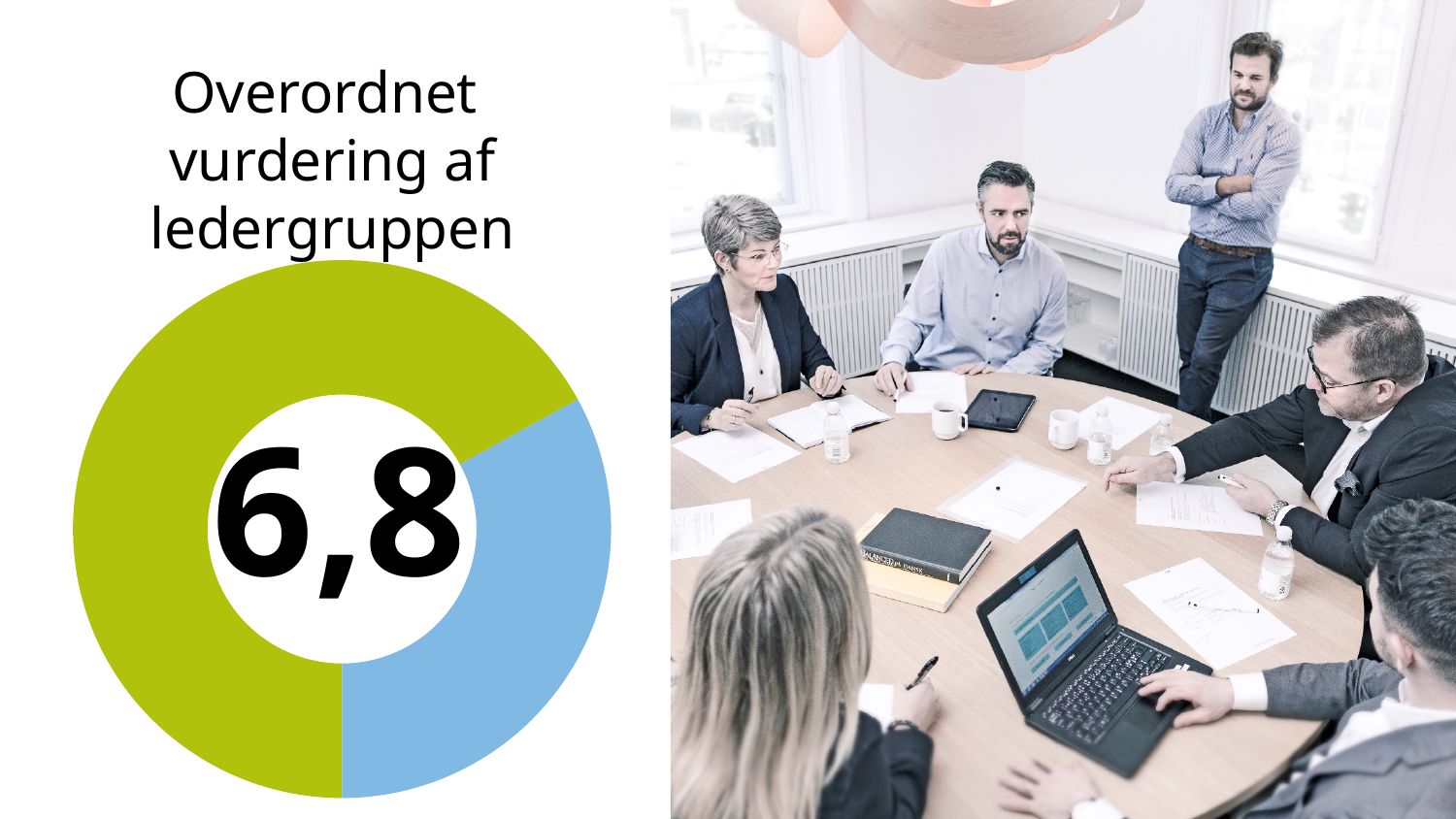
What kind of chart is shown on the slide? Donut chart Which slice of the donut chart is larger, the green one or the blue one? The green one Is the green slice of the donut chart greater or less than half of the ring? greater Is the blue slice of the donut chart greater or less than half of the ring? less Which slice of the donut chart is the largest? The green slice What two colours are used for the slices of the donut chart? Green and blue What is the title shown above the donut chart? Overordnet vurdering af ledergruppen What value is printed in the centre of the donut chart? 6,8 Which slice of the donut chart is the smallest? The blue slice How many slices does the donut chart have? 2